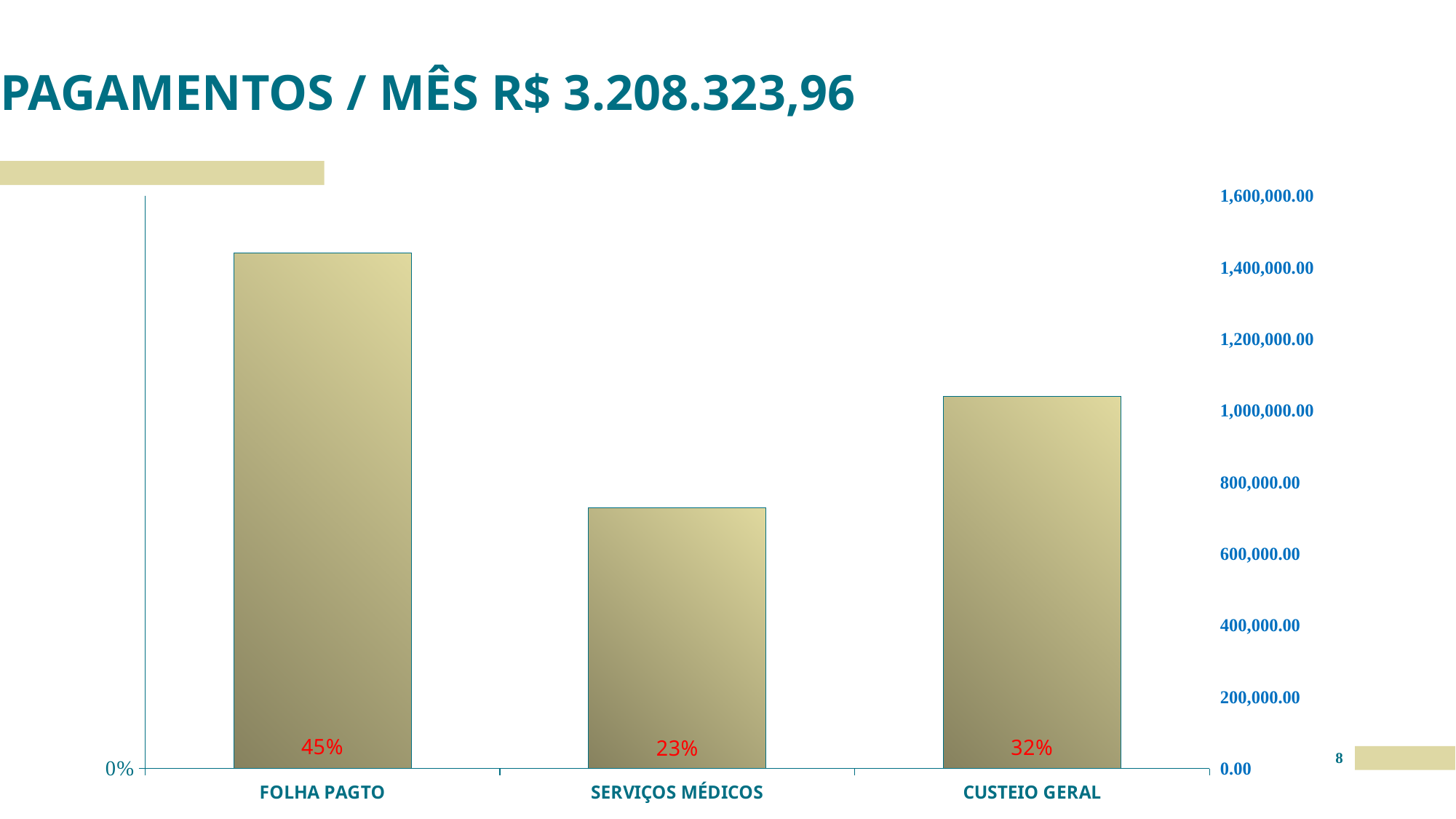
What is the percentage label shown on the SERVIÇOS MÉDICOS bar? 23% What is the percentage label shown on the CUSTEIO GERAL bar? 32% How many categories are shown on the x axis? 3 What kind of chart is shown on the slide? bar chart What is the percentage label shown on the FOLHA PAGTO bar? 45% Which category has the lowest bar? SERVIÇOS MÉDICOS Is the value for SERVIÇOS MÉDICOS on the right-hand axis greater or less than 800,000.00? less What is the difference in percentage points between the FOLHA PAGTO label and the SERVIÇOS MÉDICOS label? 22% What is the title of the slide above the chart? PAGAMENTOS / MÊS R$ 3.208.323,96 Which is larger, the bar for CUSTEIO GERAL or the bar for SERVIÇOS MÉDICOS? CUSTEIO GERAL Which category has the highest bar? FOLHA PAGTO Is the value for FOLHA PAGTO on the right-hand axis greater or less than 1,200,000.00? greater